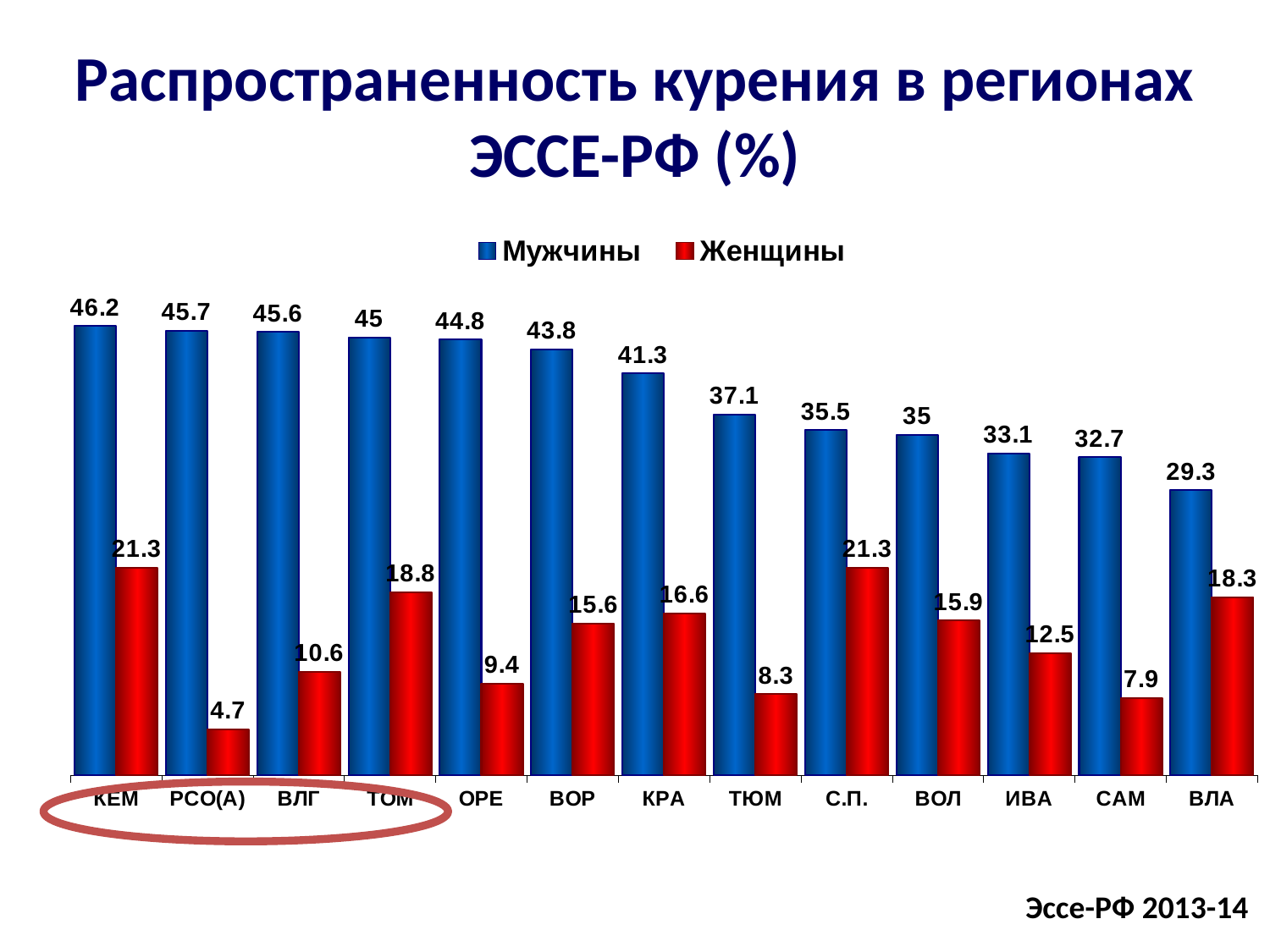
What is the value for Женщины in САМ? 7.9 What is the difference between the Мужчины and Женщины values in ВЛГ? 35 What is the value for Мужчины in КЕМ? 46.2 What kind of chart is shown on the slide? Bar chart Which region has the lowest value for Мужчины? ВЛА What is the value for Мужчины in ТЮМ? 37.1 How many series does the legend list? 2 Which region has the lowest value for Женщины? РСО(А) Which is larger: the Женщины value in КРА or the Женщины value in ВОР? КРА How many regions are shown on the x axis? 13 Which region has the highest value for Мужчины? КЕМ What is the value for Женщины in ТОМ? 18.8